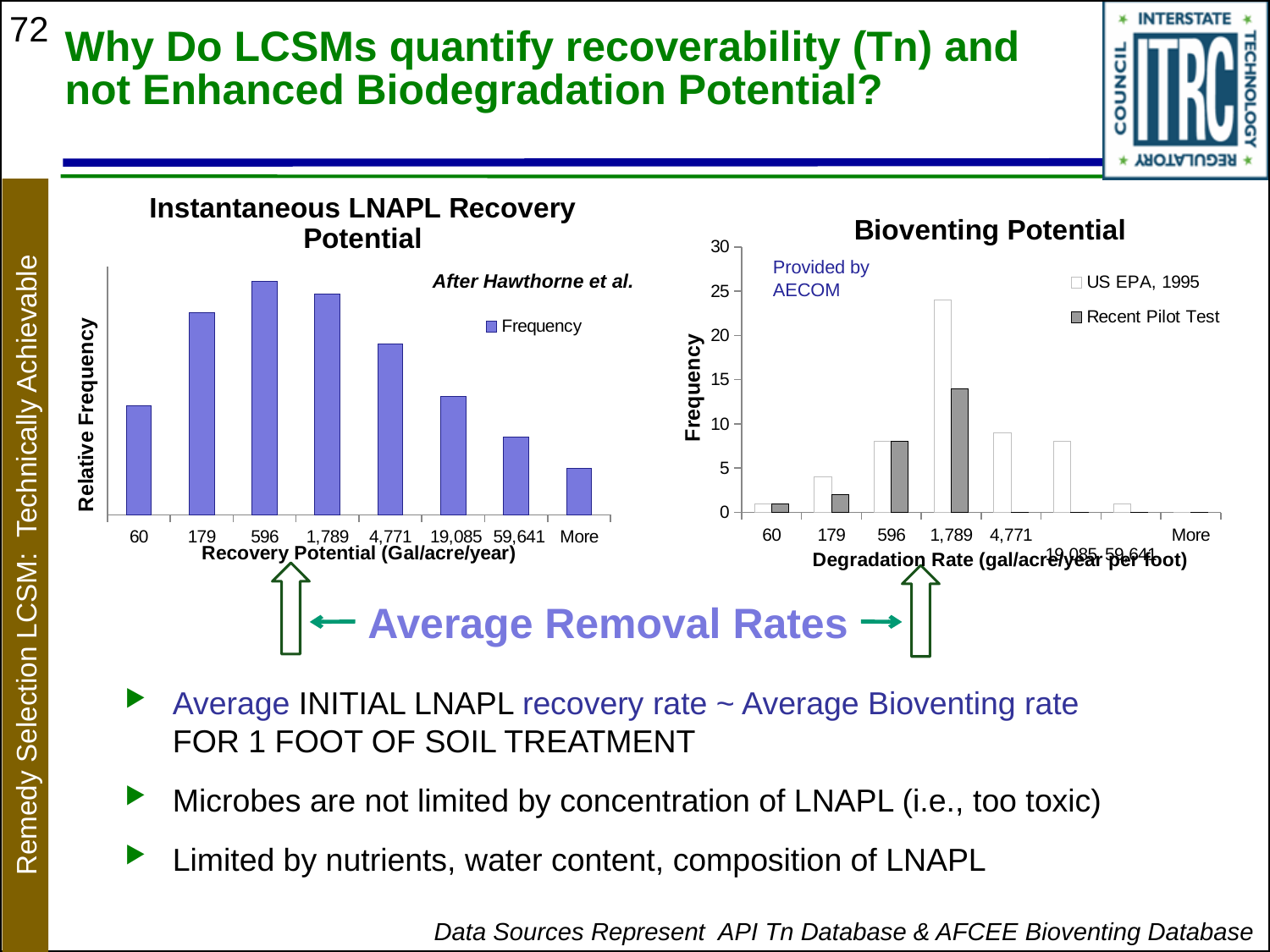
In the Bioventing Potential chart, which degradation rate category has the highest US EPA, 1995 frequency? 1,789 What is the x-axis label of the Bioventing Potential chart? Degradation Rate (gal/acre/year per foot) How many categories are shown on the x axis of the Instantaneous LNAPL Recovery Potential chart? 8 In the Bioventing Potential chart, is the Recent Pilot Test value for 1,789 greater or less than 10? greater How many series does the legend of the Bioventing Potential chart list? 2 In the Bioventing Potential chart, is the US EPA, 1995 value for 1,789 greater or less than 20? greater In the Instantaneous LNAPL Recovery Potential chart, which category has the lowest relative frequency? More What kind of chart is the Instantaneous LNAPL Recovery Potential chart? Bar chart In the Bioventing Potential chart, at 1,789 which series has the larger value, US EPA, 1995 or Recent Pilot Test? US EPA, 1995 In the Bioventing Potential chart, is the US EPA, 1995 value for 179 greater or less than 5? less In the Instantaneous LNAPL Recovery Potential chart, which is larger, the bar for 179 or the bar for 19,085? 179 In the Instantaneous LNAPL Recovery Potential chart, which recovery potential category has the highest relative frequency? 596